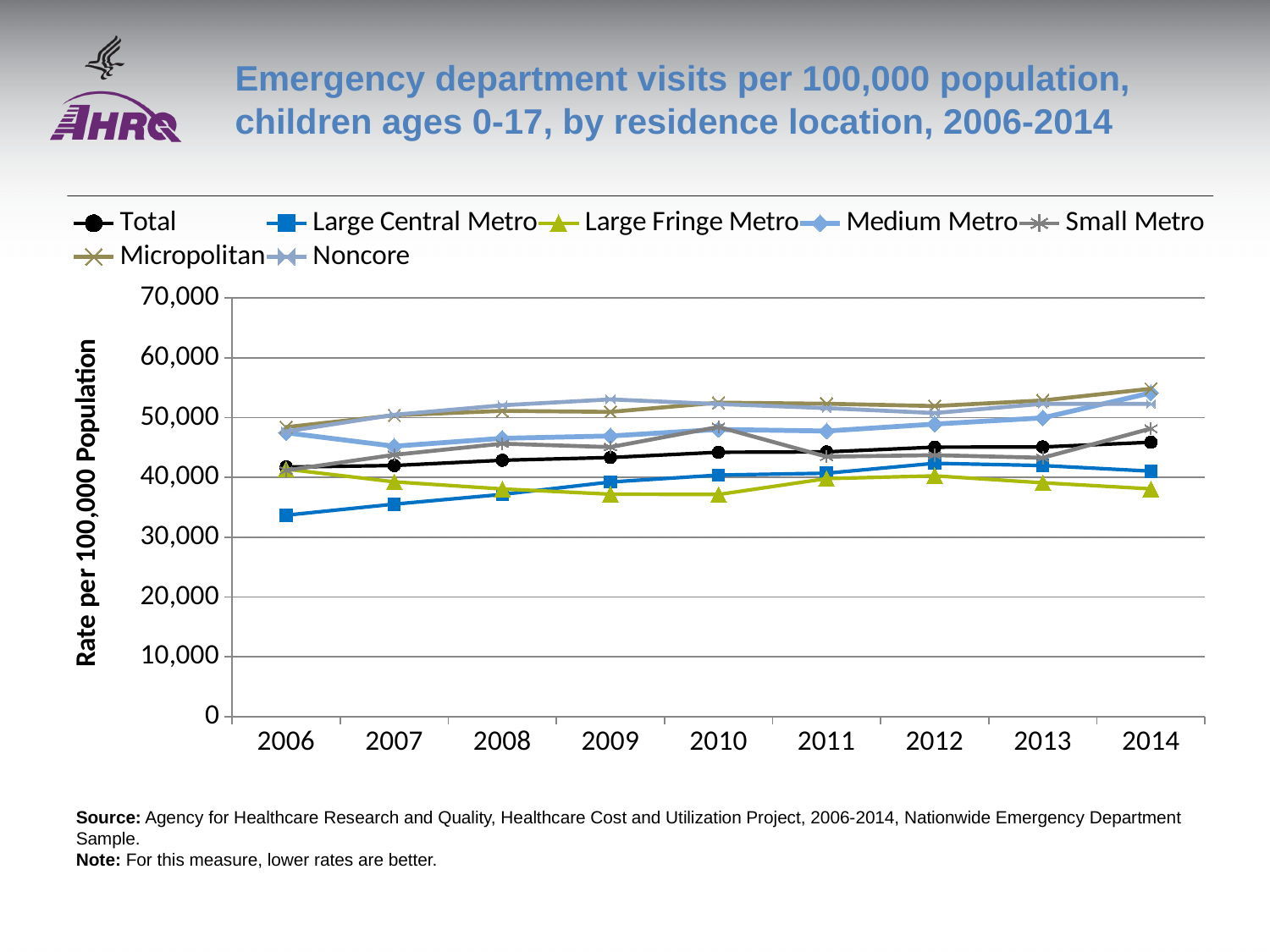
In 2006, which was larger: the rate for Large Fringe Metro or for Large Central Metro? Large Fringe Metro How many series does the legend list? 7 Is the value for Micropolitan in 2014 greater or less than 50,000? greater Is the value for Medium Metro in 2006 greater or less than 50,000? less Does the Large Central Metro rate rise or fall from 2006 to 2014? Rise Is the value for Large Central Metro in 2006 greater or less than 40,000? less In 2014, which was larger: the rate for Micropolitan or for Large Central Metro? Micropolitan How many years are shown along the x axis? 9 Which residence location had the lowest rate in 2006? Large Central Metro What kind of chart is shown on the slide? Line chart What is the title of the y axis? Rate per 100,000 Population